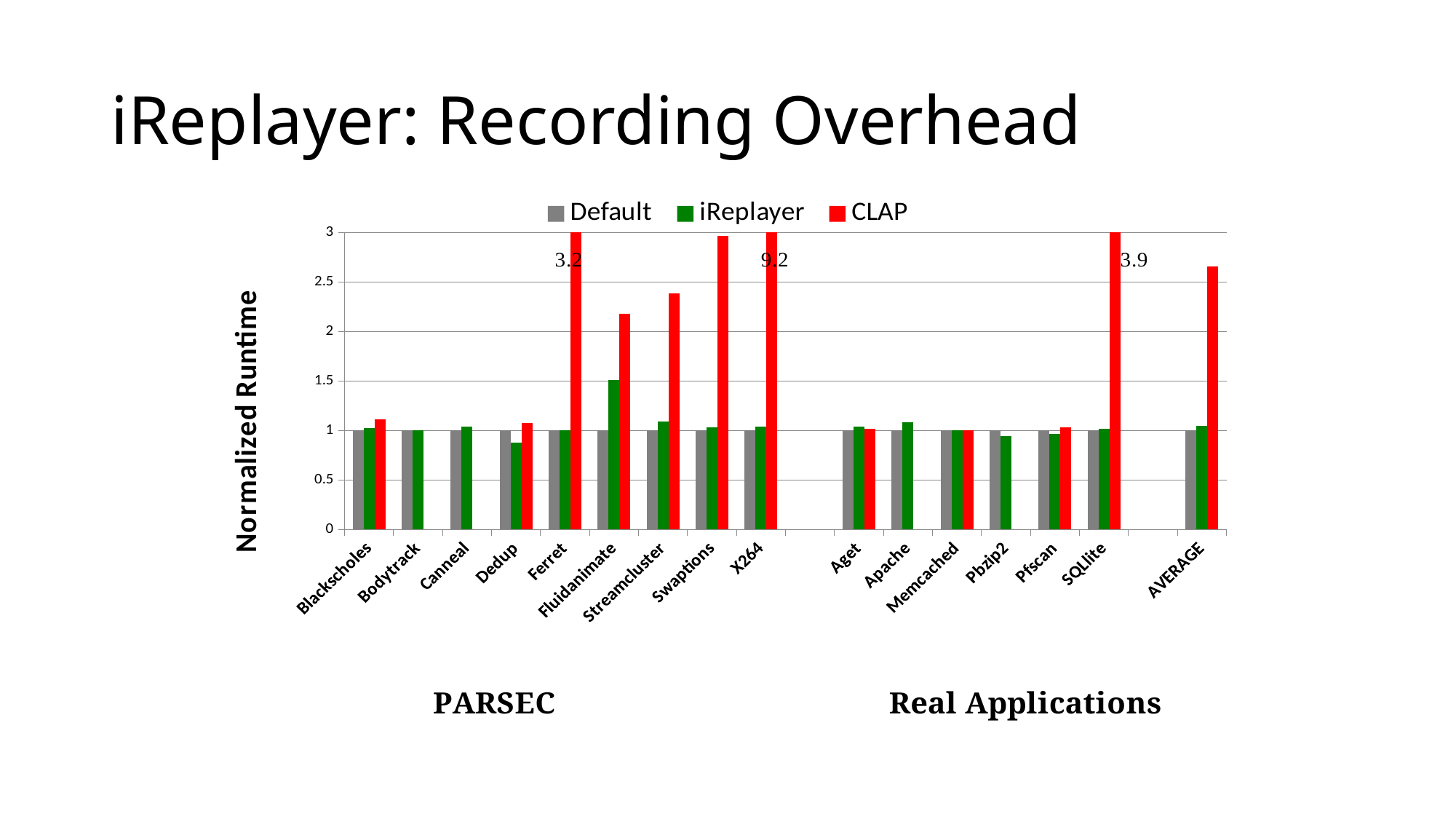
How many series does the legend list? 3 What is the CLAP value for SQLite? 3.9 What is the label of the y axis? Normalized Runtime Is the iReplayer value for Dedup greater or less than 1? less What kind of chart is shown on the slide? bar chart What is the CLAP value for Ferret? 3.2 Which category has the highest CLAP value? X264 What is the difference between the CLAP value for X264 and the CLAP value for Ferret? 6 Which is larger, the CLAP value for Ferret or the CLAP value for SQLite? SQLite Is the CLAP value for Streamcluster greater or less than 2? greater How many categories are shown along the x axis? 16 What is the CLAP value for X264? 9.2